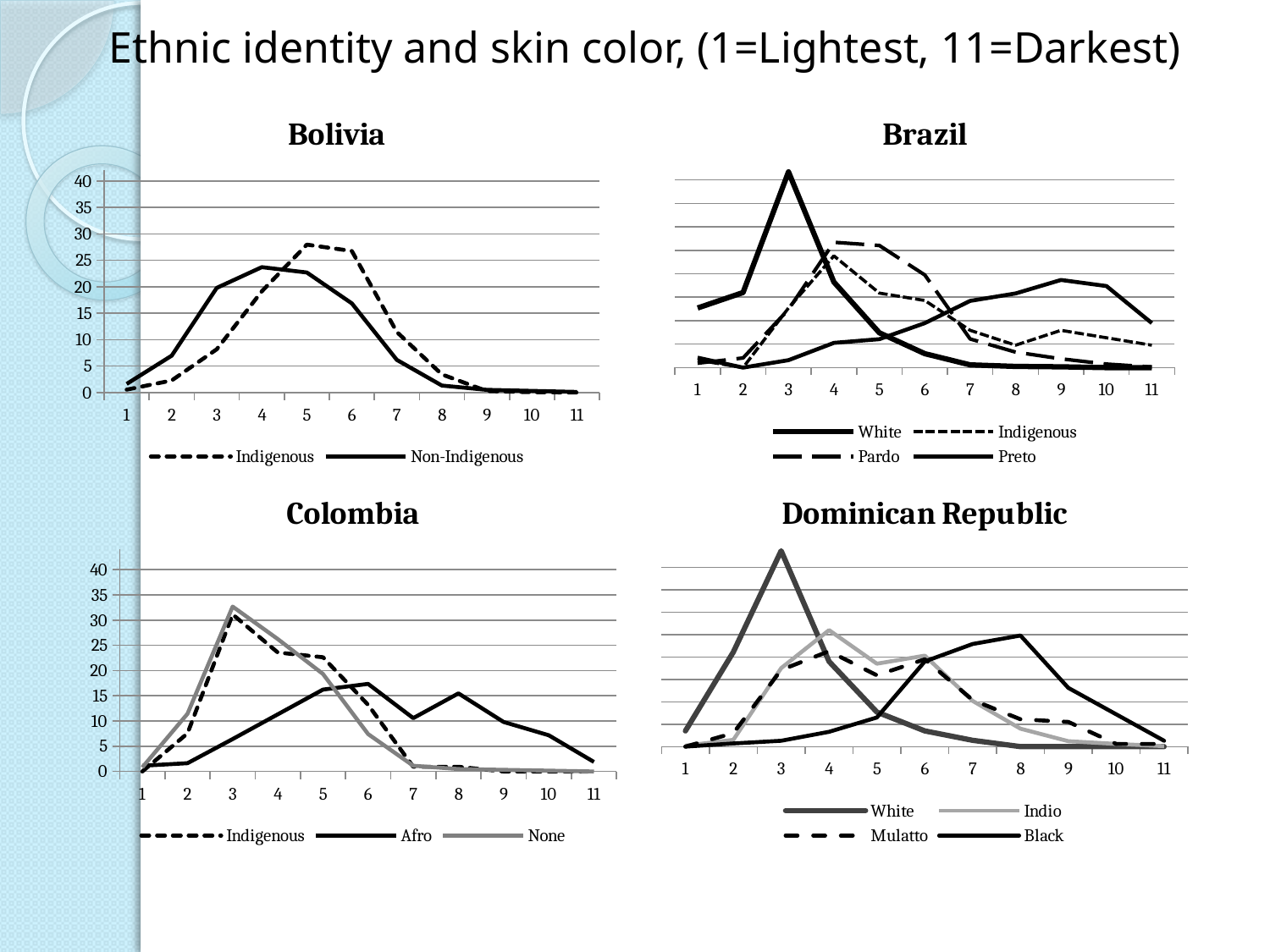
In the Dominican Republic chart, which series reaches its peak at skin color 3? White How many series does the legend of the Colombia chart list? 3 In the Bolivia chart, does the Non-Indigenous series rise or fall from skin color 4 to skin color 11? fall In the Bolivia chart, how many points are plotted along the x axis for each series? 11 In the Bolivia chart, is the value for Indigenous at skin color 5 greater or less than 25? greater In the Colombia chart, is the value for None at skin color 3 greater or less than 30? greater What kind of chart is the Bolivia chart? line chart In the Bolivia chart, is the value for Non-Indigenous at skin color 7 greater or less than 10? less How many series does the legend of the Brazil chart list? 4 In the Colombia chart, at skin color 6, which series has the larger value, Afro or None? Afro In the Bolivia chart, at skin color 5, which series has the larger value, Indigenous or Non-Indigenous? Indigenous How many charts are shown on the slide? 4